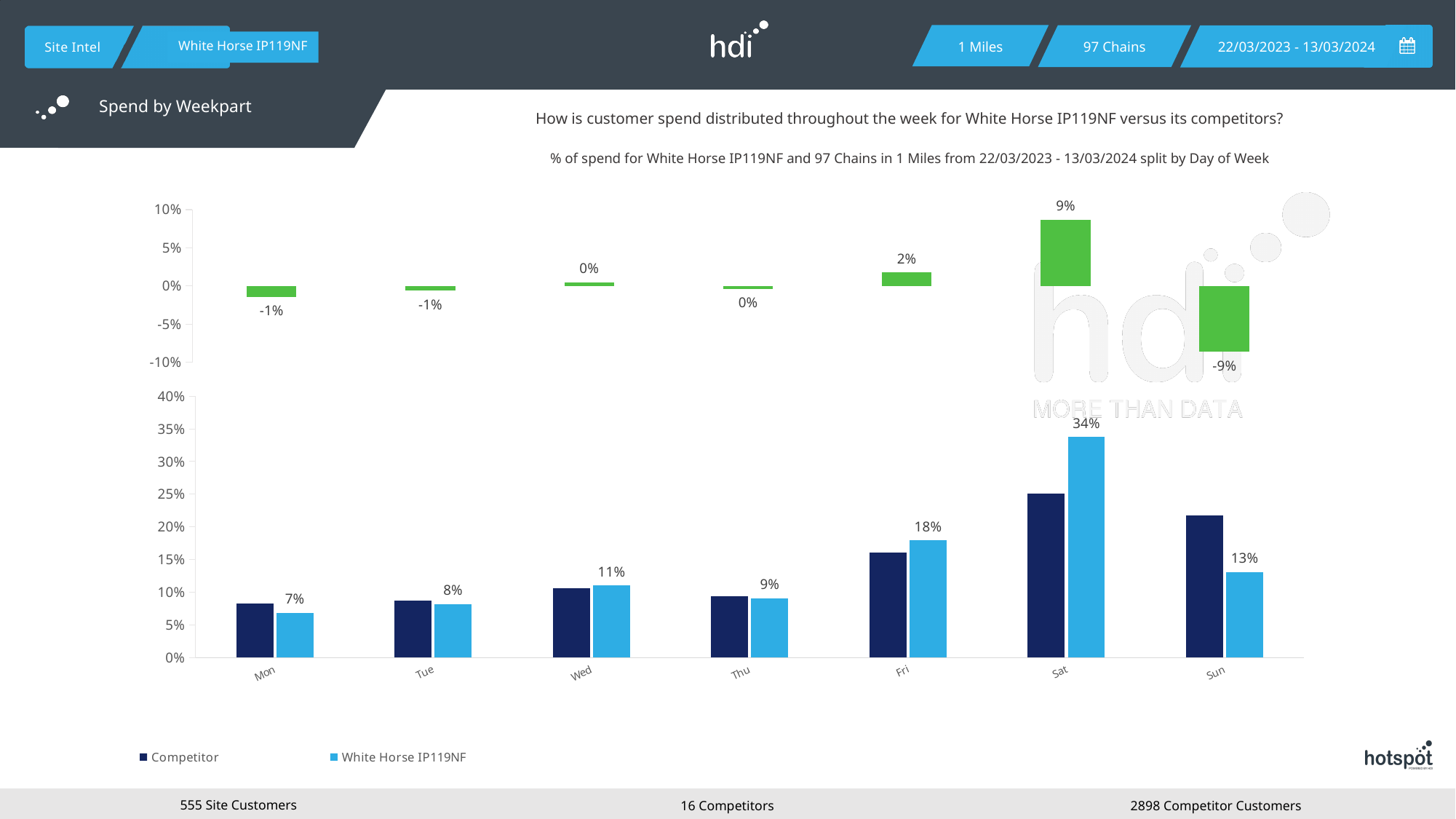
In the bottom chart, is the Competitor value for Sun greater or less than 20%? greater In the bottom chart, which day has the lowest White Horse IP119NF value? Mon In the top chart, what is the value for Sun? -9% In the bottom chart, what is the value for White Horse IP119NF on Fri? 18% In the bottom chart, what is the value for White Horse IP119NF on Sat? 34% In the bottom chart, which is larger on Sat: the Competitor bar or the White Horse IP119NF bar? White Horse IP119NF How many days are shown on the x axis of the bottom chart? 7 In the top chart, which day has the highest value? Sat How many series does the legend of the bottom chart list? 2 In the bottom chart, what is the value for White Horse IP119NF on Mon? 7% In the bottom chart, which day has the highest White Horse IP119NF value? Sat In the bottom chart, what is the difference between the White Horse IP119NF values for Sat and Sun? 21%